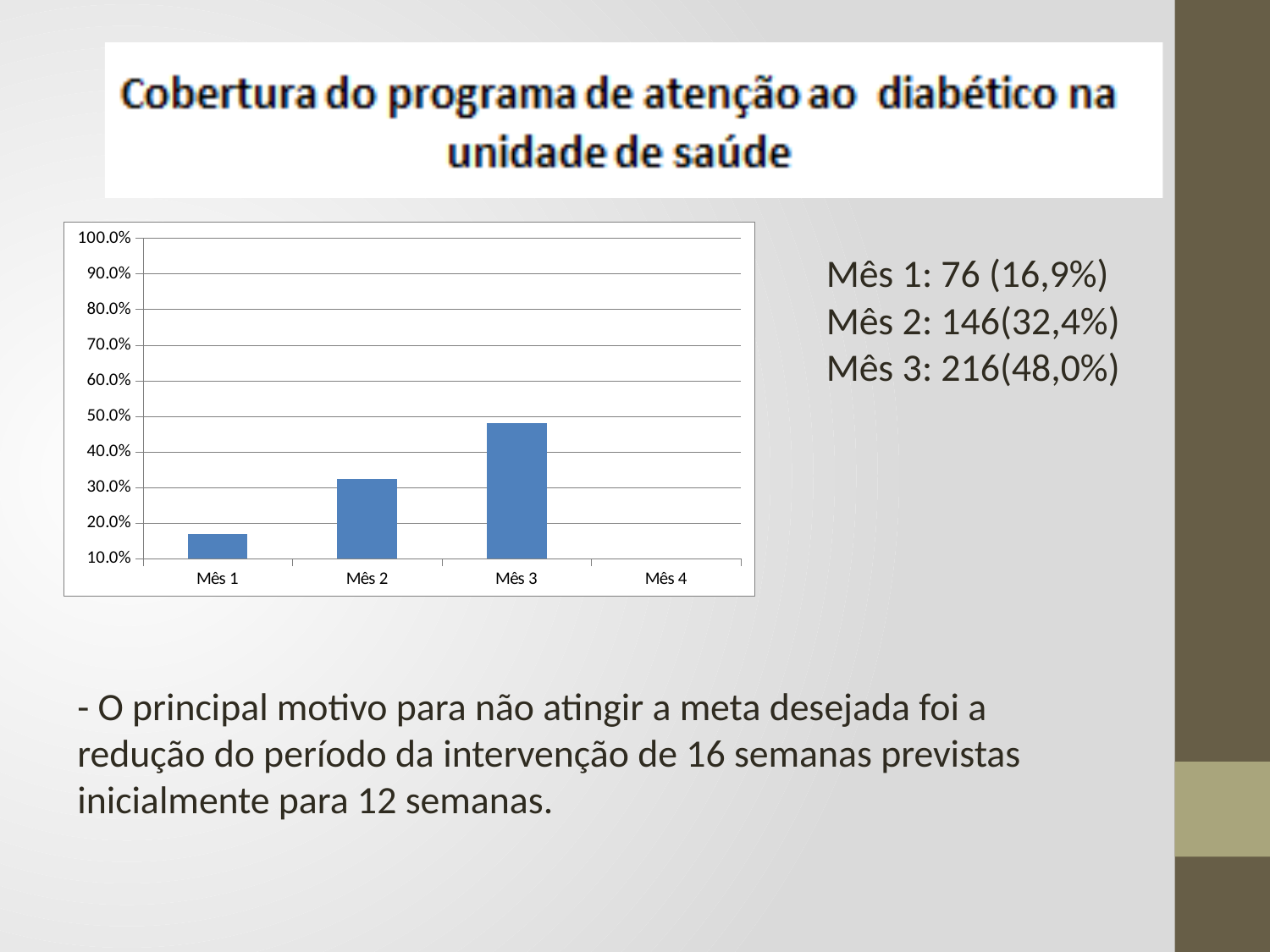
What kind of chart is shown on the slide? bar chart Is the value for Mês 3 greater or less than 50.0%? less Is the value for Mês 2 greater or less than 30.0%? greater How many categories are shown on the x axis of the chart? 4 According to the text beside the chart, what percentage coverage was reached in Mês 3? 48,0% Which is larger, the value for Mês 2 or the value for Mês 3? Mês 3 What is the title of the chart? Cobertura do programa de atenção ao diabético na unidade de saúde Do the bar values rise or fall from Mês 1 to Mês 3? rise Is the value for Mês 1 greater or less than 20.0%? less Which month has the highest bar in the chart? Mês 3 Using the percentages printed beside the chart, what is the difference between Mês 3 and Mês 1? 31,1% Among the months with a plotted bar, which has the lowest value? Mês 1